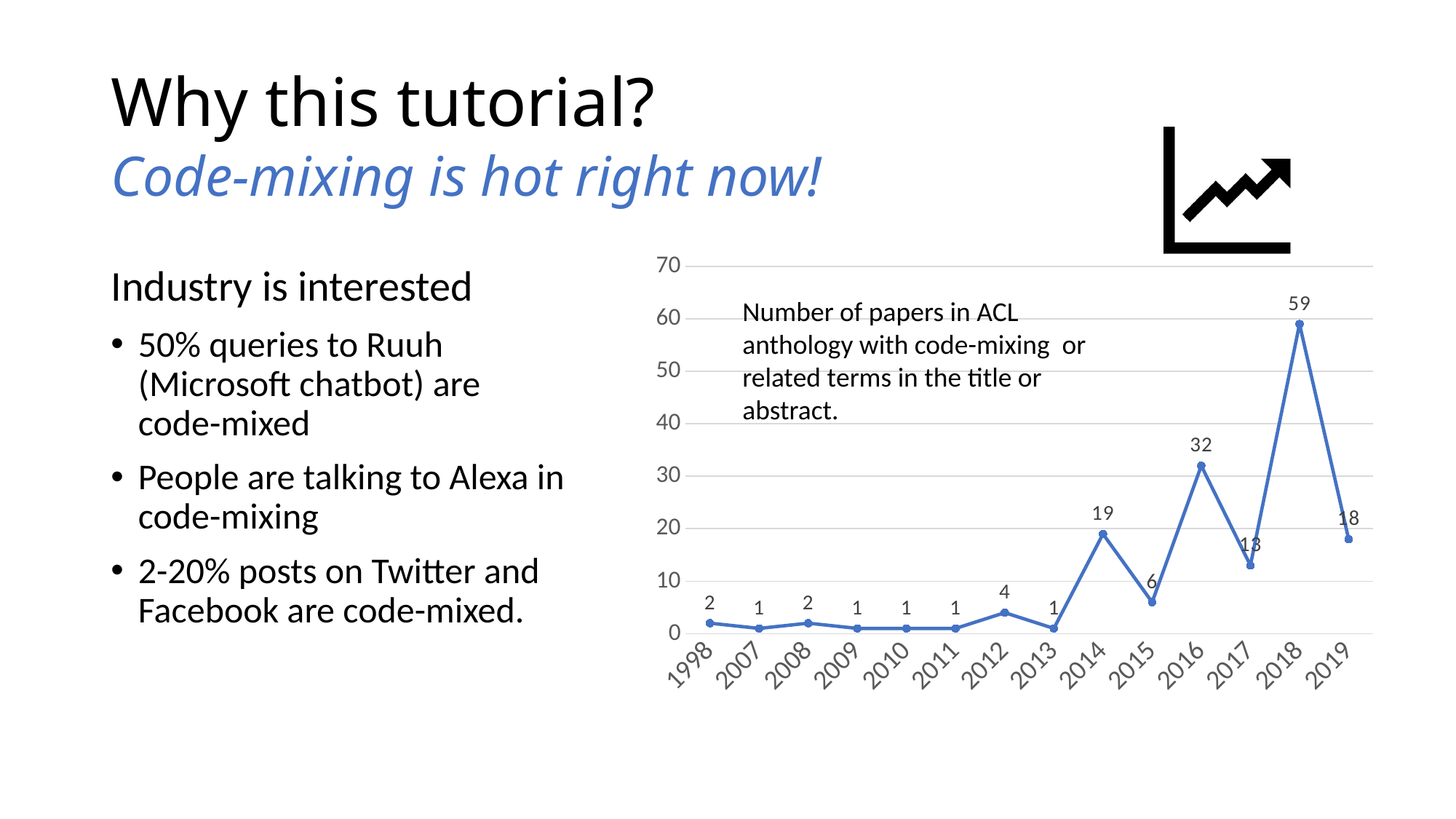
What is the difference between the number of papers in 2018 and 2019? 41 Is the value for 2016 greater or less than 30? greater Which year has the highest number of papers? 2018 What is the number of papers in 2014? 19 What is the number of papers in 2016? 32 Which year has more papers, 2015 or 2017? 2017 What does the chart show, according to the text inside it? Number of papers in ACL anthology with code-mixing or related terms in the title or abstract. What is the difference between the number of papers in 2016 and 2017? 19 How many years are shown on the x axis? 14 What is the number of papers in 2019? 18 What is the number of papers in 2018? 59 What kind of chart is shown on the slide? line chart